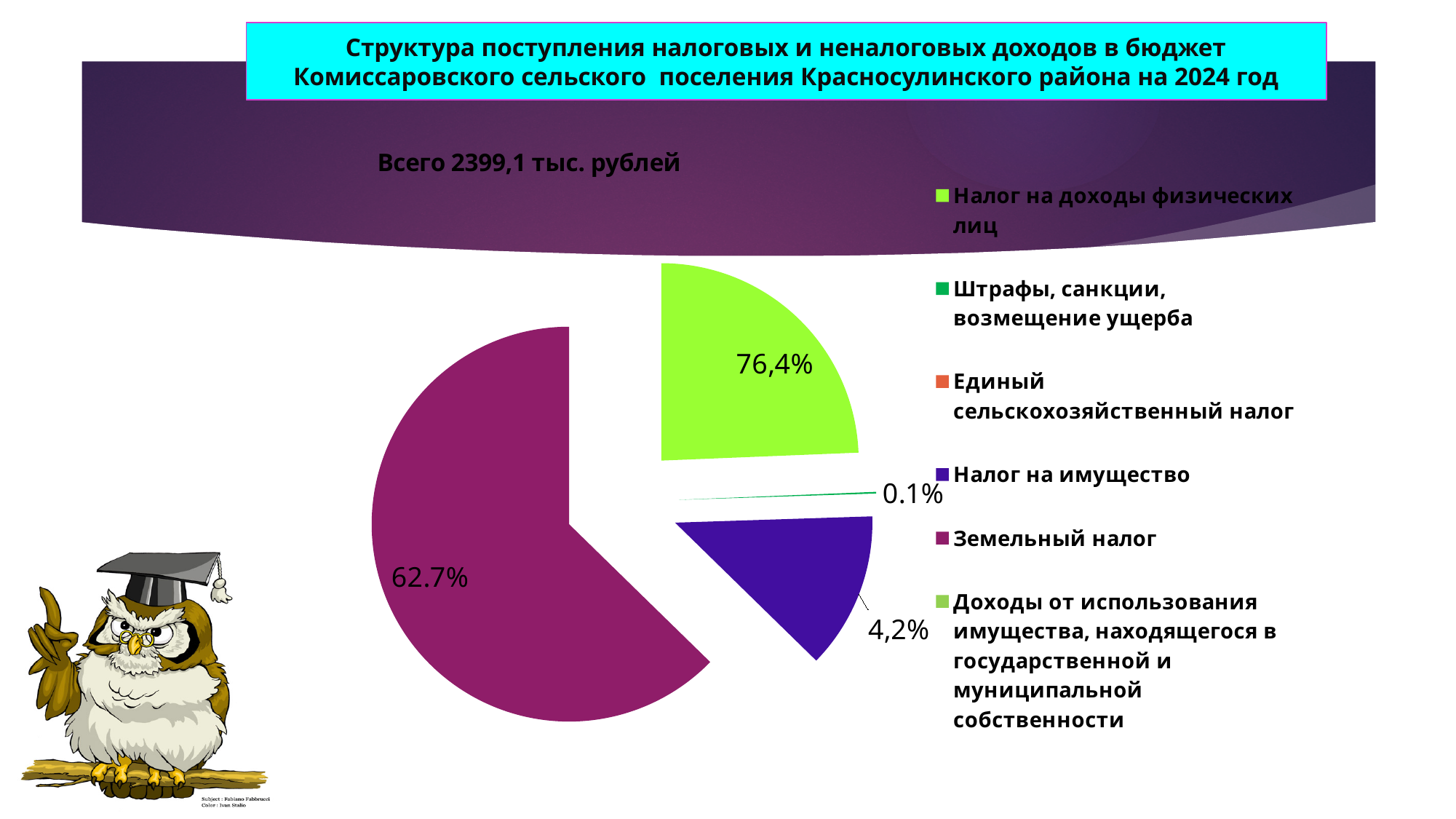
How many slices of the pie have a percentage label printed? 4 What share of the pie is labelled for Штрафы, санкции, возмещение ущерба? 0.1% What share of the pie is labelled for Налог на доходы физических лиц? 76,4% Which category has the smallest slice of the pie? Штрафы, санкции, возмещение ущерба What share of the pie is labelled for Налог на имущество? 4,2% How many entries does the legend of the pie chart list? 6 What total amount is stated above the pie chart? Всего 2399,1 тыс. рублей What kind of chart is shown on the slide? pie chart What colour is the slice for Земельный налог? magenta (purple-red) What share of the pie is labelled for Земельный налог? 62.7% Which is larger: the slice for Налог на имущество or the slice for Штрафы, санкции, возмещение ущерба? Налог на имущество